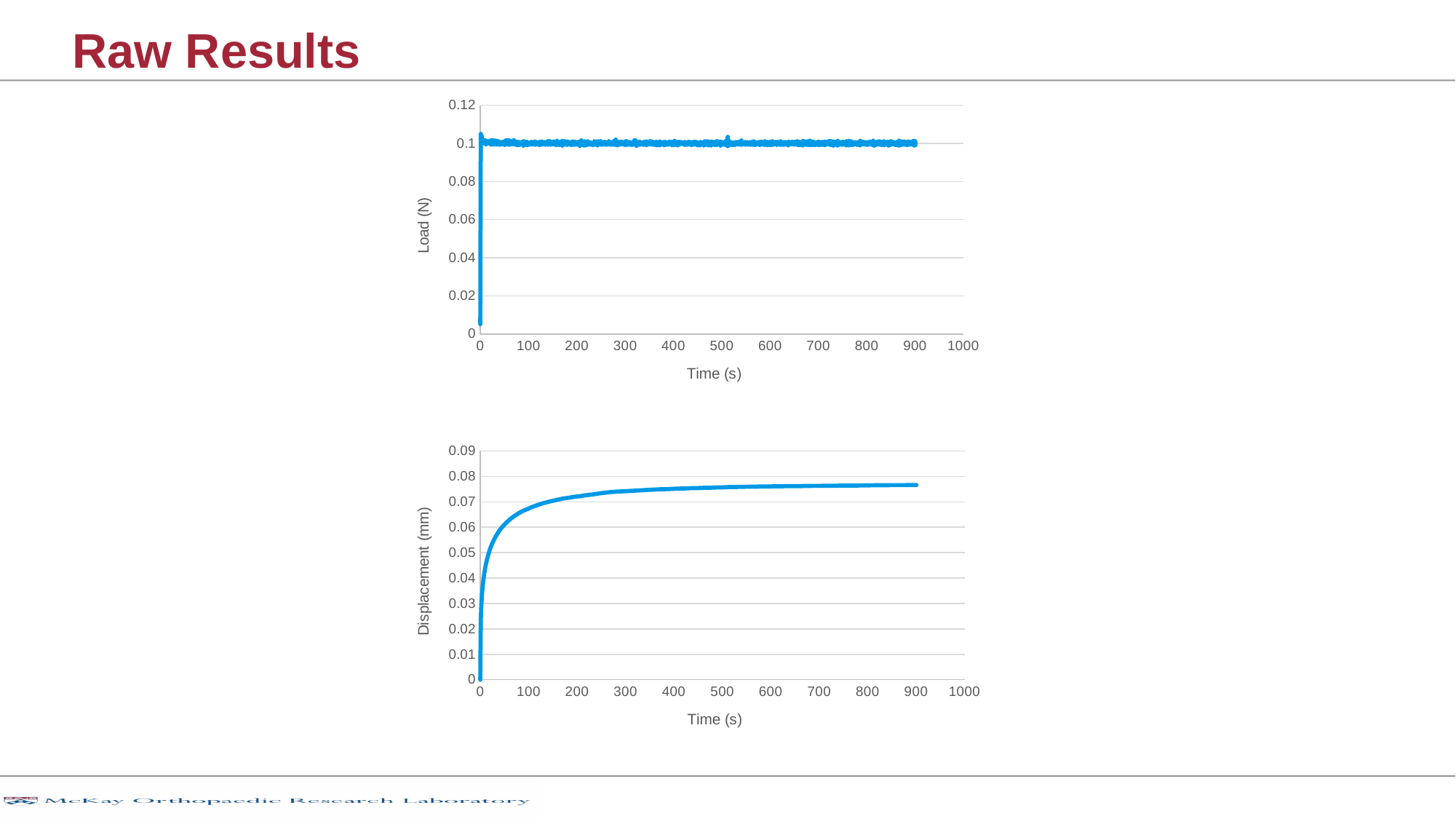
In the top chart, does the load rise, fall, or stay roughly constant between 100 s and 900 s? stays roughly constant How many charts are shown on the slide? 2 In the bottom chart, is the displacement at 900 s greater or less than 0.08? less In the bottom chart, is the displacement at 100 s greater or less than 0.06? greater What kind of chart is the top chart on the slide? line chart In the top chart, is the load at 500 s greater or less than 0.08? greater In the top chart, what is the label of the y axis? Load (N) In the bottom chart, does the displacement rise or fall as time increases from 0 to 900 s? rise In the bottom chart, what is the label of the y axis? Displacement (mm) What kind of chart is the bottom chart on the slide? line chart